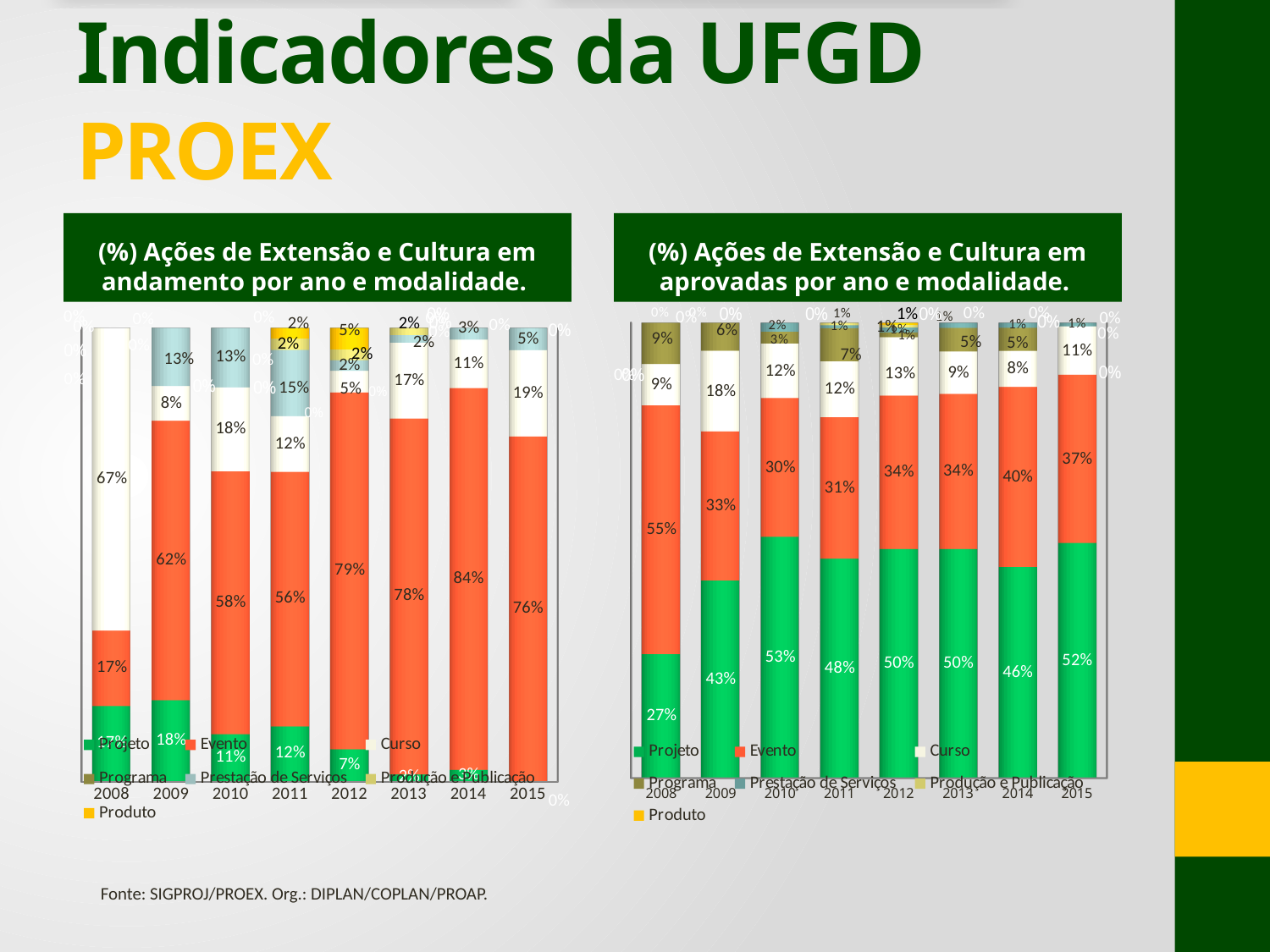
In the left chart, '(%) Ações de Extensão e Cultura em andamento por ano e modalidade', what is the value for Curso in 2008? 67% What kind of chart is the right chart, '(%) Ações de Extensão e Cultura em aprovadas por ano e modalidade'? Stacked bar chart How many series does the legend of the left chart, '(%) Ações de Extensão e Cultura em andamento por ano e modalidade', list? 7 In the left chart, '(%) Ações de Extensão e Cultura em andamento por ano e modalidade', which is larger: the Curso value in 2010 or in 2015? 2015 How many years are shown on the x axis of the right chart, '(%) Ações de Extensão e Cultura em aprovadas por ano e modalidade'? 8 In the right chart, '(%) Ações de Extensão e Cultura em aprovadas por ano e modalidade', what is the value for Evento in 2008? 55% In the right chart, '(%) Ações de Extensão e Cultura em aprovadas por ano e modalidade', what is the value for Projeto in 2010? 53% In the right chart, '(%) Ações de Extensão e Cultura em aprovadas por ano e modalidade', which year has the lowest value for Projeto? 2008 In the right chart, '(%) Ações de Extensão e Cultura em aprovadas por ano e modalidade', which colour represents Projeto? Green In the right chart, '(%) Ações de Extensão e Cultura em aprovadas por ano e modalidade', what is the difference between the Evento values for 2008 and 2015? 18% In the left chart, '(%) Ações de Extensão e Cultura em andamento por ano e modalidade', what is the value for Evento in 2014? 84% In the left chart, '(%) Ações de Extensão e Cultura em andamento por ano e modalidade', which year has the highest value for Evento? 2014